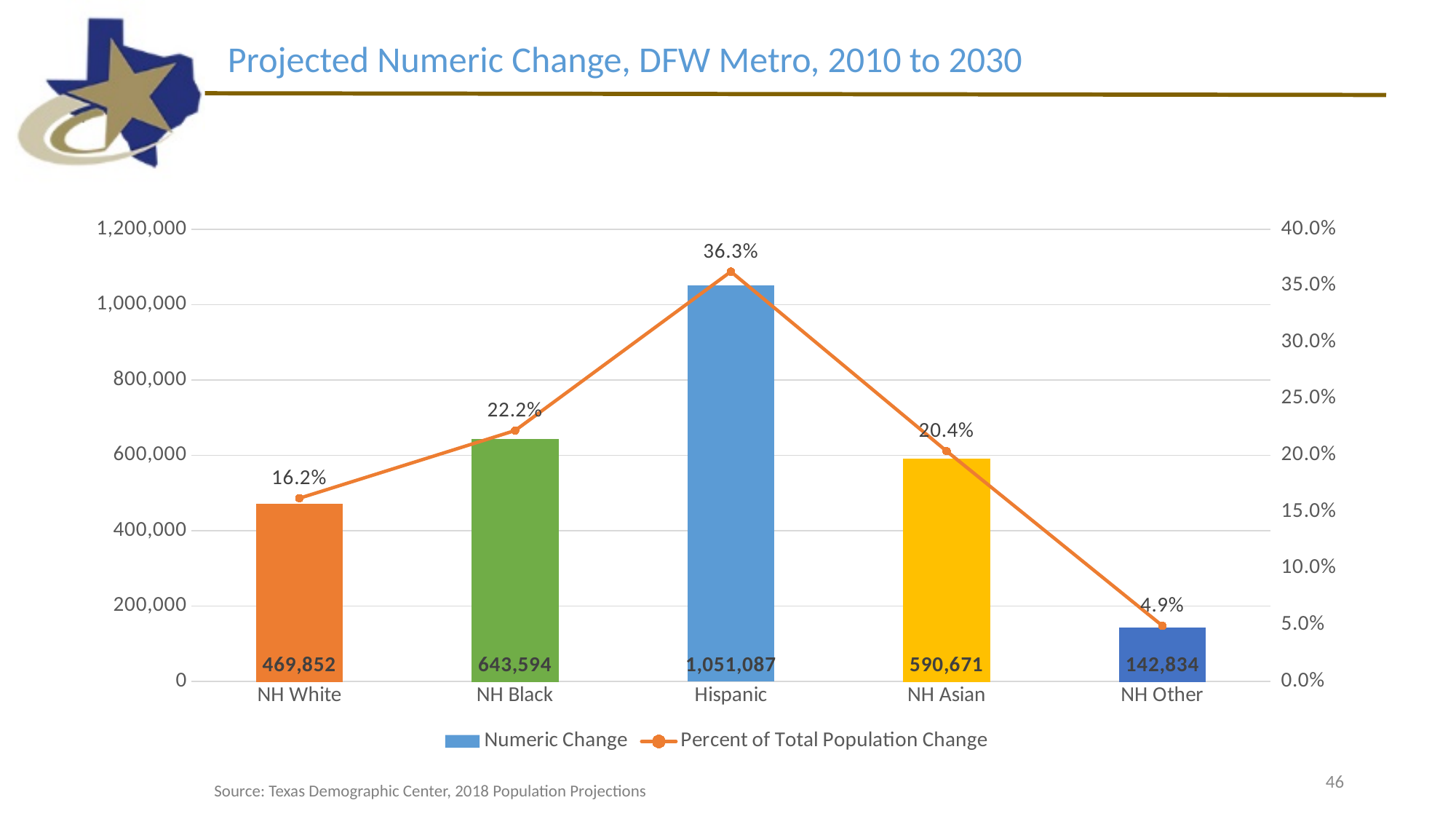
How many categories are shown on the x axis? 5 Which category has the lowest percent of total population change? NH Other What kind of chart is used to show Numeric Change? Bar chart What is the projected numeric change for Hispanic? 1,051,087 Which category has the highest projected numeric change? Hispanic Which has a larger numeric change, NH Black or NH Asian? NH Black What is the difference in numeric change between NH Black and NH White? 173,742 What percent of total population change is attributed to NH Asian? 20.4% What is the title of the chart? Projected Numeric Change, DFW Metro, 2010 to 2030 What is the projected numeric change for NH Other? 142,834 How many series does the legend list? 2 What percent of total population change is attributed to NH Black? 22.2%